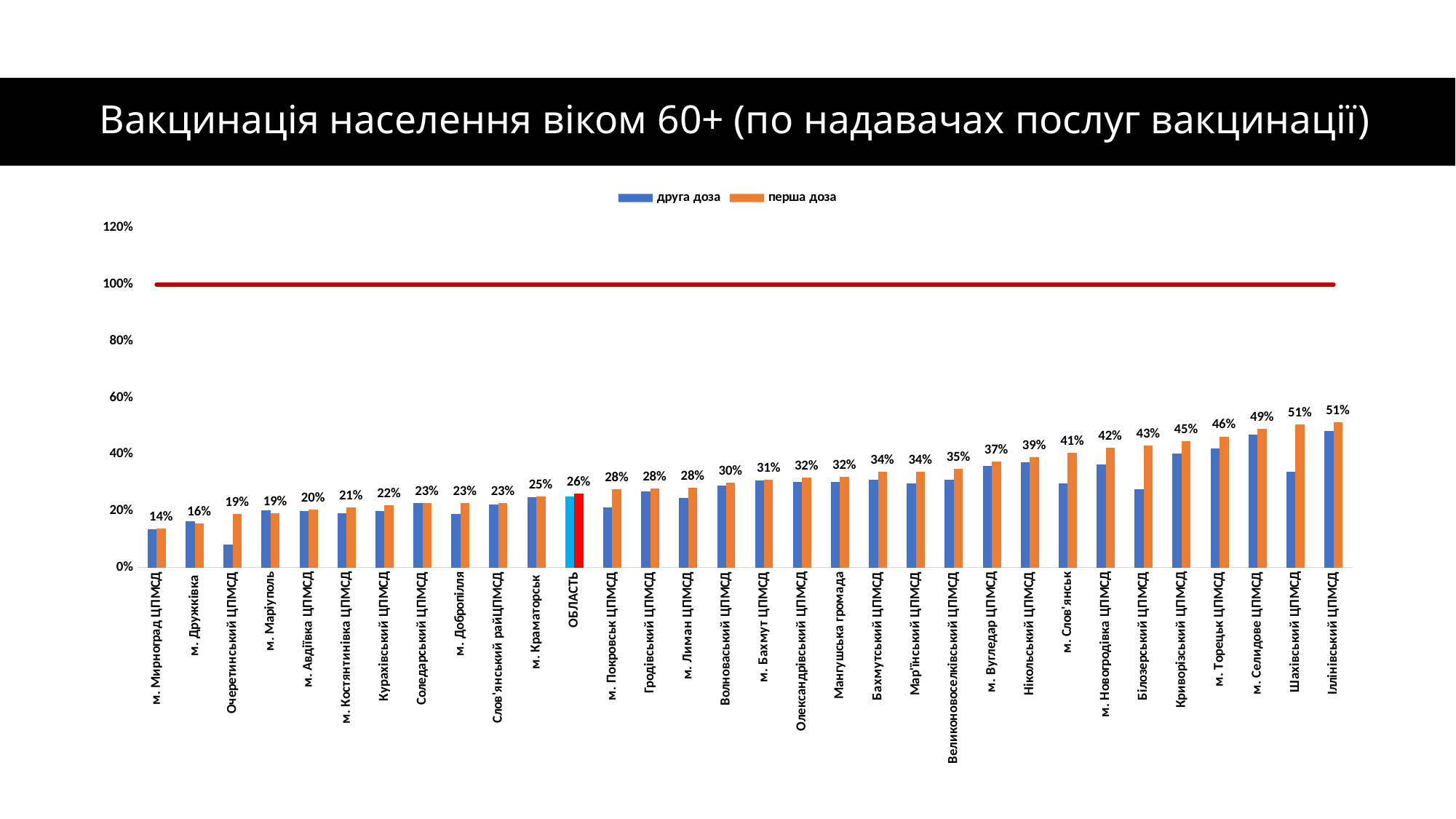
What is the labelled first-dose (перша доза) value for ОБЛАСТЬ? 26% Which has the larger labelled first-dose value, м. Селидове ЦПМСД or м. Вугледар ЦПМСД? м. Селидове ЦПМСД What kind of chart is shown on the slide? bar chart What is the difference between the labelled first-dose values for Криворізький ЦПМСД and м. Покровськ ЦПМСД? 17% Is the second-dose (друга доза) value for Очеретинський ЦПМСД greater or less than 20%? less Which category has the lowest labelled first-dose value? м. Мирноград ЦПМСД How many categories are plotted along the x axis? 32 What are the two series named in the legend? друга доза, перша доза What is the labelled first-dose value for м. Маріуполь? 19% How many series does the legend list? 2 What is the labelled first-dose value for м. Слов'янськ? 41% Do the labelled first-dose values rise or fall from left to right along the x axis? rise